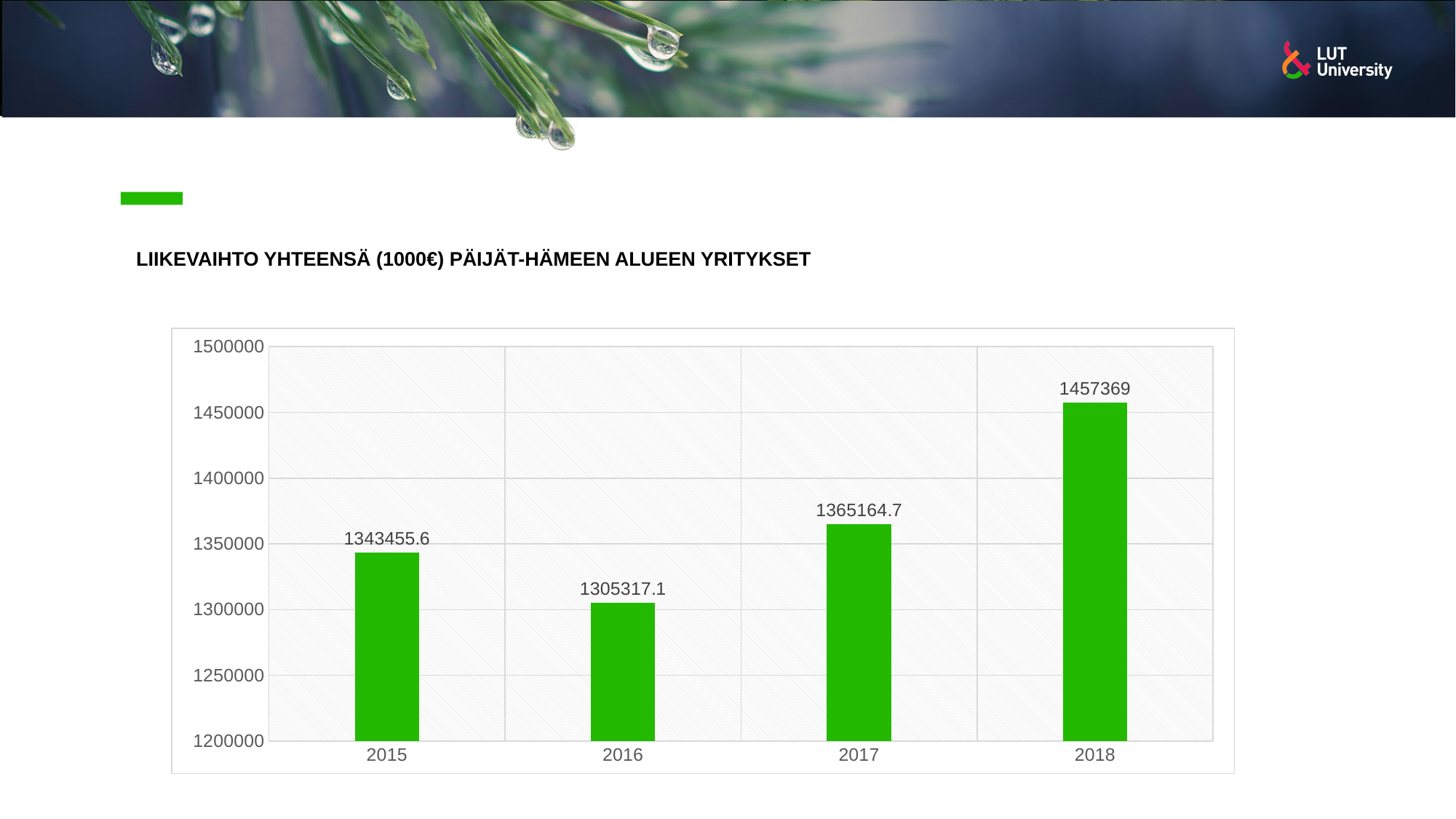
What is the value for 2018? 1457369 Which is larger, the value for 2015 or the value for 2017? 2017 Which year has the highest value? 2018 What is the value for 2016? 1305317.1 What is the difference between the values for 2015 and 2016? 38138.5 What is the value for 2017? 1365164.7 What is the difference between the values for 2018 and 2017? 92204.3 How many years are shown on the x axis? 4 What kind of chart is shown on the slide? bar chart Which year has the lowest value? 2016 What is the value for 2015? 1343455.6 Is the value for 2018 greater or less than 1400000? greater